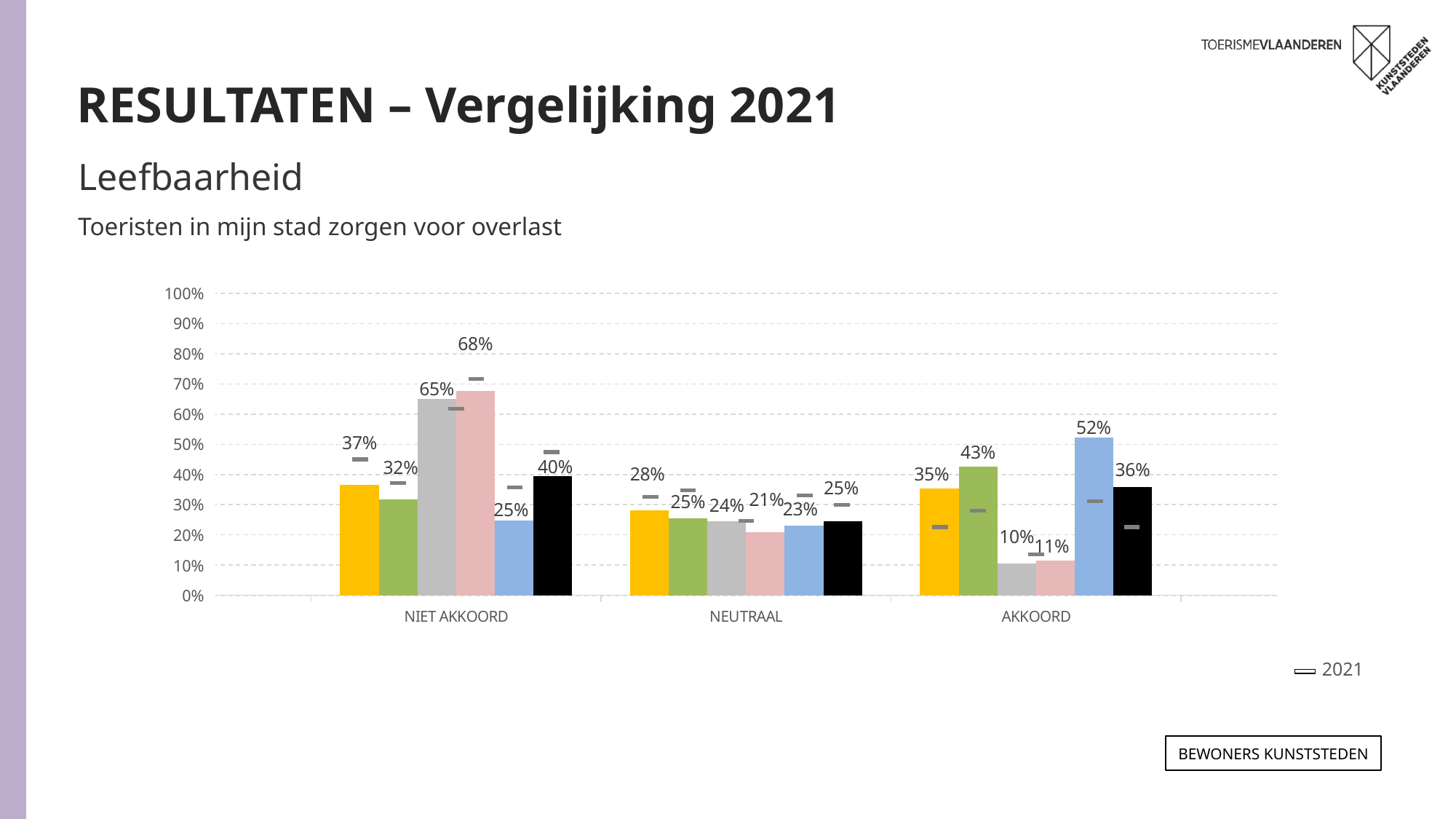
What is the value of the yellow bar in the NEUTRAAL category? 28% Is the 2021 marker for the yellow bar in the AKKOORD category greater or less than 30%? less Which coloured bar is the lowest in the AKKOORD category? Grey What is the difference between the grey bar and the pink bar in the NIET AKKOORD category? 3% What is the difference between the blue bar and the green bar in the AKKOORD category? 9% What is the value of the pink bar in the NIET AKKOORD category? 68% What is the value of the blue bar in the AKKOORD category? 52% How many categories are shown on the x axis of the chart? 3 What is the value of the grey bar in the AKKOORD category? 10% What kind of chart is shown on the slide? Bar chart Which coloured bar is the highest in the NIET AKKOORD category? Pink Which is larger in the NEUTRAAL category: the yellow bar or the pink bar? Yellow bar